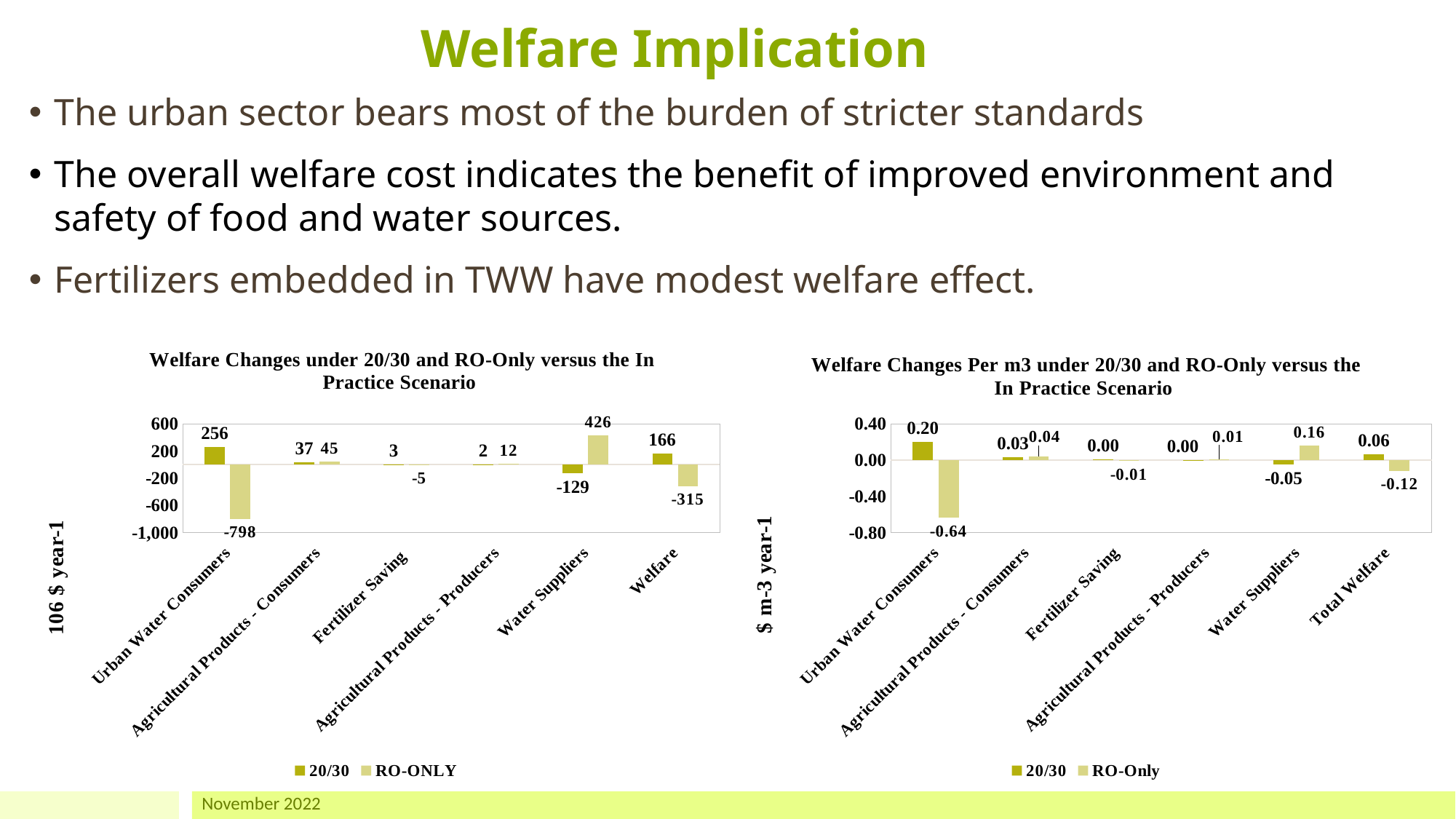
What type of chart is the right chart (Welfare Changes Per m3)? Bar chart In the left chart (Welfare Changes under 20/30 and RO-Only), which category has the lowest RO-ONLY value? Urban Water Consumers In the right chart (Welfare Changes Per m3), how many series does the legend list? 2 In the left chart (Welfare Changes under 20/30 and RO-Only), which is larger for Agricultural Products - Consumers: the 20/30 value or the RO-ONLY value? RO-ONLY In the left chart (Welfare Changes under 20/30 and RO-Only), how many categories are shown on the x axis? 6 In the right chart (Welfare Changes Per m3), which category has the highest 20/30 value? Urban Water Consumers In the left chart (Welfare Changes under 20/30 and RO-Only), what is the RO-ONLY value for Water Suppliers? 426 In the right chart (Welfare Changes Per m3), what is the 20/30 value for Total Welfare? 0.06 In the left chart (Welfare Changes under 20/30 and RO-Only), what is the RO-ONLY value for Urban Water Consumers? -798 In the left chart (Welfare Changes under 20/30 and RO-Only), what is the difference between the 20/30 and RO-ONLY values for Welfare? 481 In the right chart (Welfare Changes Per m3), what is the RO-Only value for Urban Water Consumers? -0.64 In the left chart (Welfare Changes under 20/30 and RO-Only), what is the 20/30 value for Urban Water Consumers? 256